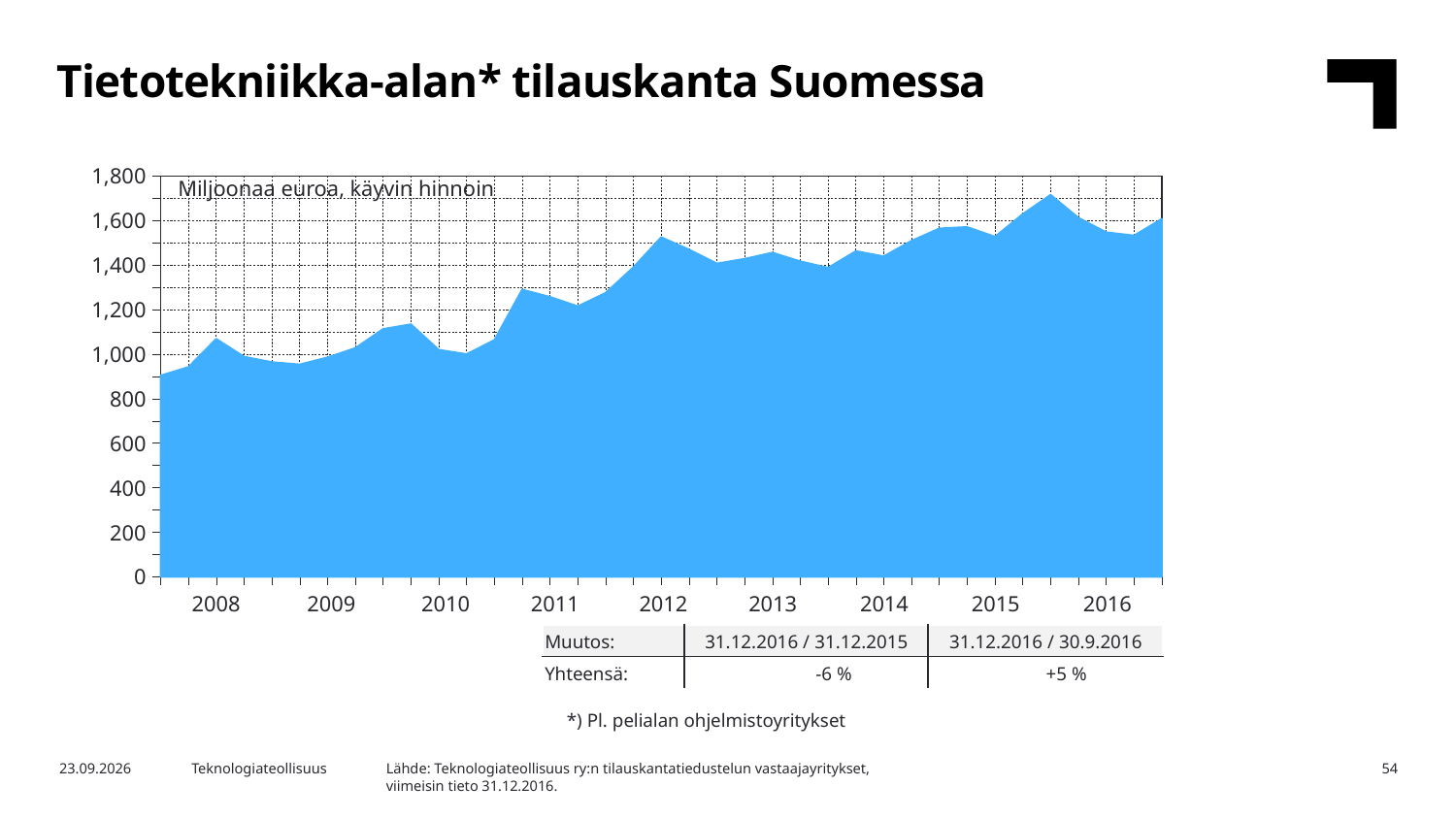
What is the title of the chart on the slide? Tietotekniikka-alan* tilauskanta Suomessa How many year labels are shown on the x axis? 9 What is the highest value shown on the y axis? 1,800 Overall, do the values rise or fall from 2008 to 2016? Rise Is the peak value in 2015 greater or less than 1,600? greater In which year does the chart reach its highest value? 2015 Which is larger, the value at the start of 2009 or the value at the start of 2013? 2013 What unit is stated inside the chart area? Miljoonaa euroa, käyvin hinnoin Is the value at the start of 2008 greater or less than 1,000? less What kind of chart is shown on the slide? Area chart